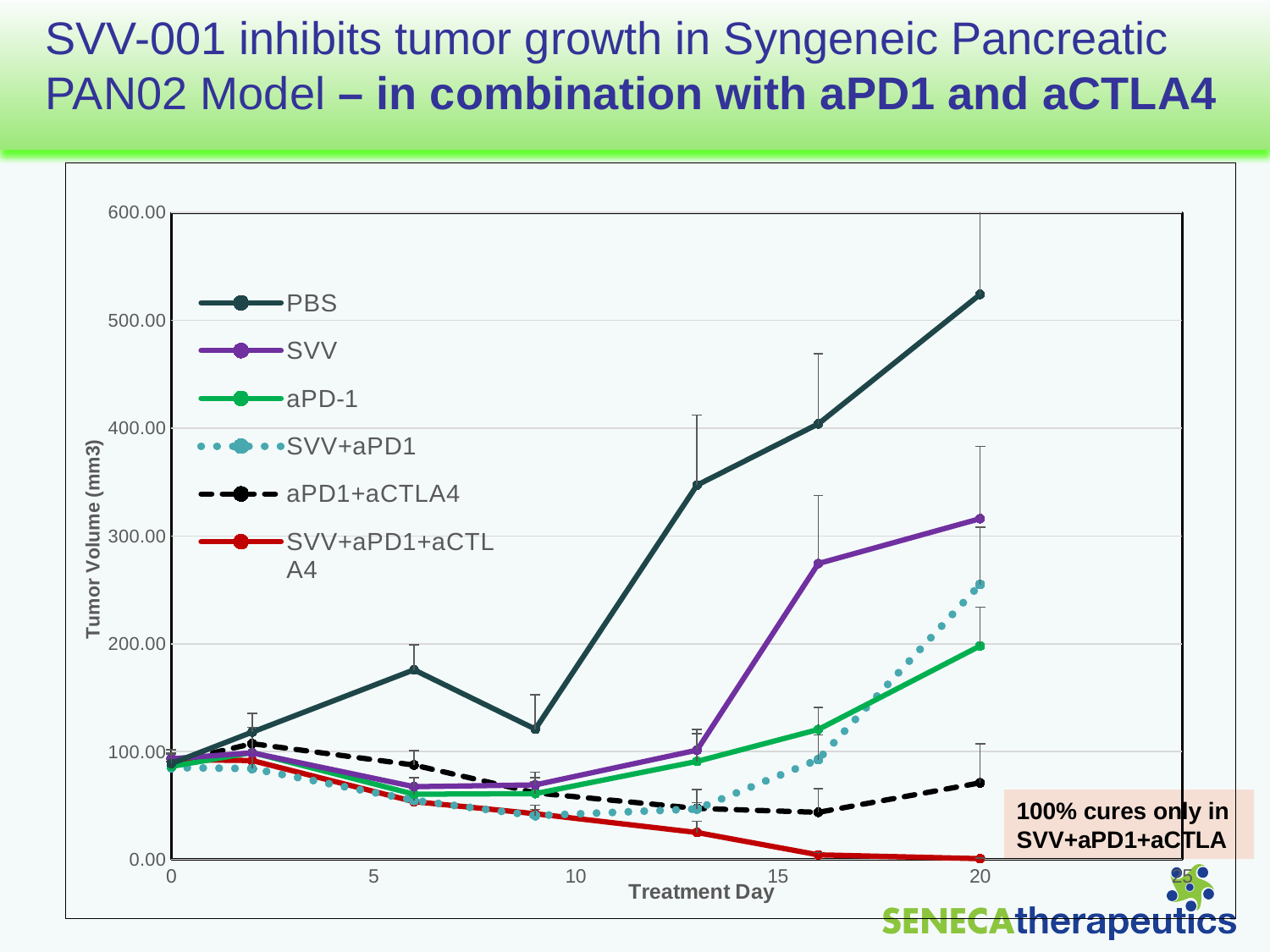
At treatment day 20, which series has the larger tumor volume, aPD-1 or SVV+aPD1? SVV+aPD1 Which series has the highest tumor volume at treatment day 20? PBS Is the tumor volume for PBS at treatment day 13 greater or less than 300? greater Is the tumor volume for aPD1+aCTLA4 at treatment day 20 greater or less than 100? less Does the tumor volume for SVV+aPD1+aCTLA4 rise or fall from treatment day 2 to treatment day 20? fall Which series has the lowest tumor volume at treatment day 20? SVV+aPD1+aCTLA4 Is the tumor volume for PBS at treatment day 20 greater or less than 500? greater What is the title of the y axis? Tumor Volume (mm3) At treatment day 20, which series has the larger tumor volume, PBS or SVV? PBS How many series does the legend list? 6 What kind of chart is shown on the slide? Line chart